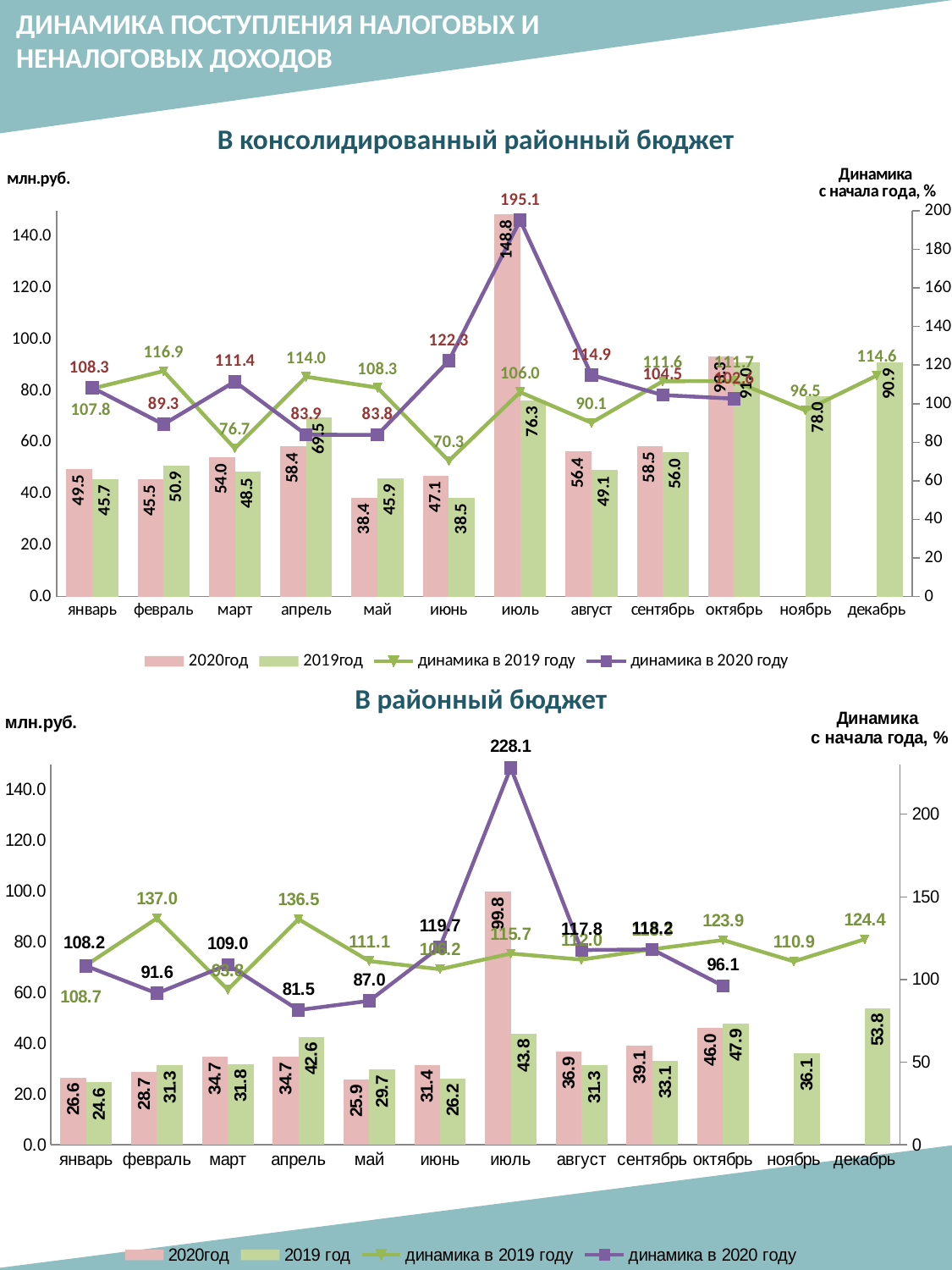
In the chart 'В районный бюджет', which month has the lowest 2020 bar? май In the chart 'В районный бюджет', what is the value of the 2020 bar for июль? 99.8 In the chart 'В консолидированный районный бюджет', what is the peak value of the 'динамика в 2020 году' line? 195.1 In the chart 'В районный бюджет', what is the difference between the 2019 bars for декабрь and ноябрь? 17.7 In the chart 'В консолидированный районный бюджет', how many series does the legend list? 4 In the chart 'В районный бюджет', what is the value of the 'динамика в 2020 году' line for июль? 228.1 In the chart 'В консолидированный районный бюджет', what is the difference between the 2020 and 2019 bars for июль? 72.5 In the chart 'В консолидированный районный бюджет', what is the value of the 2019 bar for декабрь? 90.9 In the chart 'В консолидированный районный бюджет', which month has the highest 2020 bar? июль In the chart 'В районный бюджет', which is larger for апрель: the 2020 bar or the 2019 bar? 2019 bar How many months are shown on the x axis of the chart 'В районный бюджет'? 12 In the chart 'В консолидированный районный бюджет', what is the value of the 2020 bar for июль? 148.8